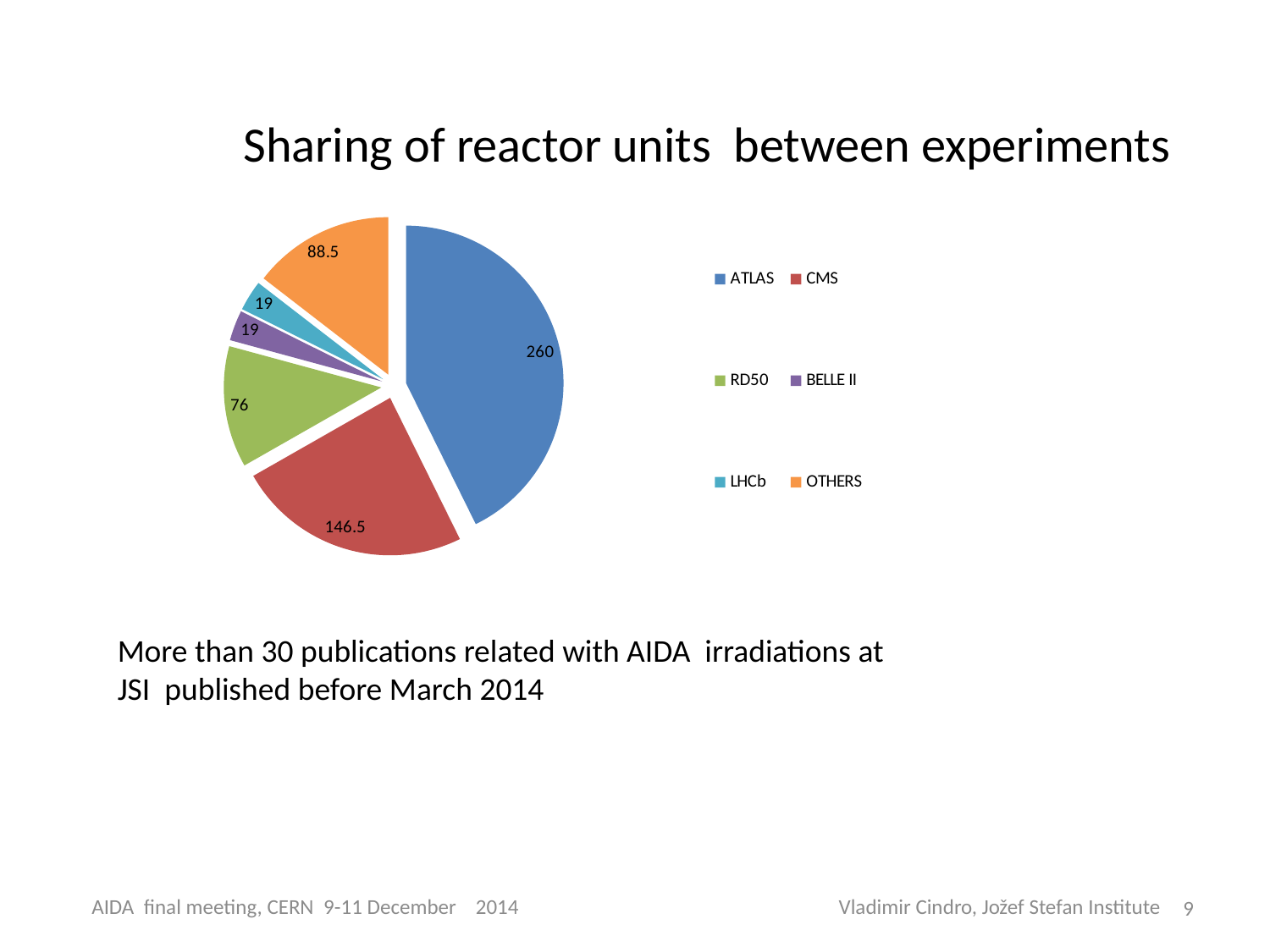
What kind of chart is shown on the slide? Pie chart Which experiment has the largest share of reactor units? ATLAS What value is shown for the ATLAS slice? 260 What value is shown for the CMS slice? 146.5 What is the difference between the OTHERS and RD50 values? 12.5 What value is shown for the RD50 slice? 76 What value is shown for the OTHERS slice? 88.5 What value is shown for the LHCb slice? 19 What is the difference between the ATLAS and CMS values? 113.5 Which is larger, the CMS slice or the RD50 slice? CMS How many slices does the pie chart have? 6 What is the title of the chart? Sharing of reactor units between experiments